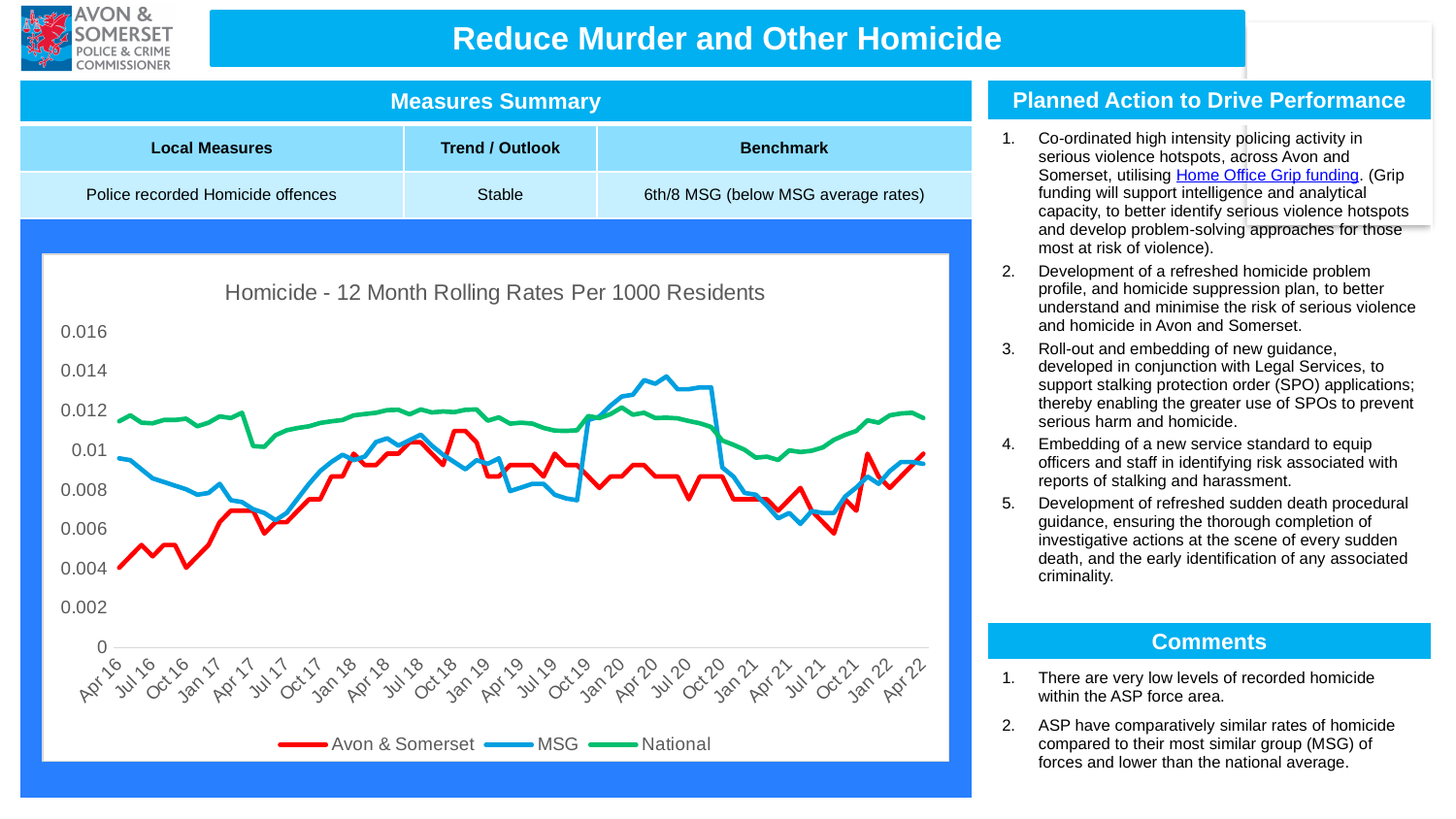
Is the value for National at Apr 16 greater or less than 0.01? greater How many labels are shown along the x axis of the chart? 25 Is the value for MSG at Apr 20 greater or less than 0.012? greater Is the value for Avon & Somerset at Apr 16 greater or less than 0.006? less Does the Avon & Somerset line rise or fall between Apr 16 and Apr 18? Rise What is the title of the chart? Homicide - 12 Month Rolling Rates Per 1000 Residents How many series does the chart legend list? 3 At Apr 20, which is larger: the MSG value or the National value? MSG Which series has the lowest value at Apr 16? Avon & Somerset What kind of chart is shown on the slide? Line chart Which series has the highest value at Apr 16? National Which series is drawn in green on the chart? National